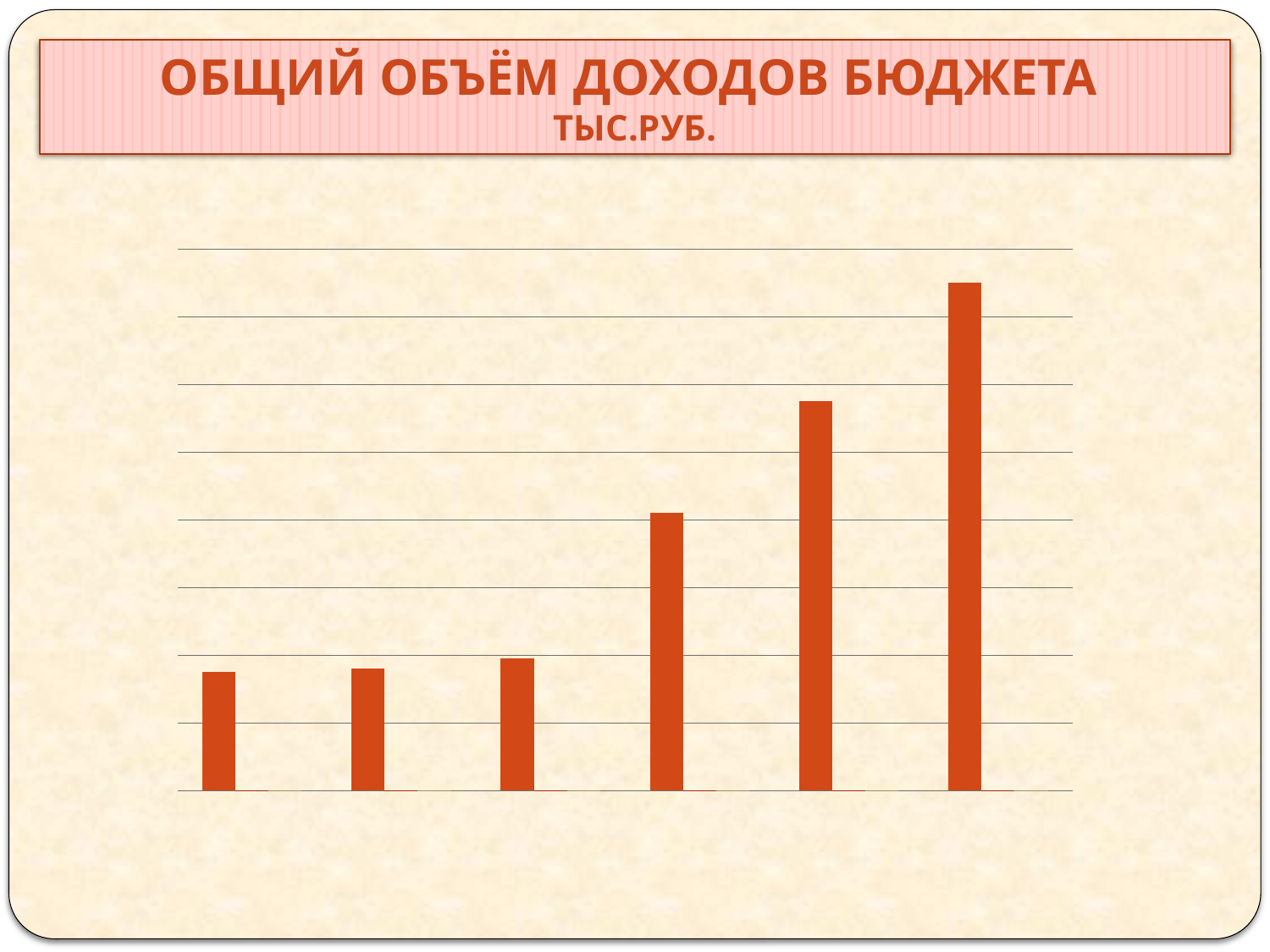
What is the title of the chart on the slide? ОБЩИЙ ОБЪЁМ ДОХОДОВ БЮДЖЕТА Which is larger, the fourth bar from the left or the third bar from the left? the fourth bar What kind of chart is shown on the slide? bar chart Do the bar values rise or fall from left to right across the chart? rise How many bars are plotted in the chart? 6 Which is larger, the second bar from the left or the fourth bar from the left? the fourth bar Which bar is the shortest in the chart, counting from the left? the first In what units are the values of the chart expressed, according to the title? ТЫС.РУБ. Which is larger, the fifth bar from the left or the sixth bar from the left? the sixth bar Which bar is the tallest: the first from the left or the last (sixth) from the left? the last (sixth) from the left